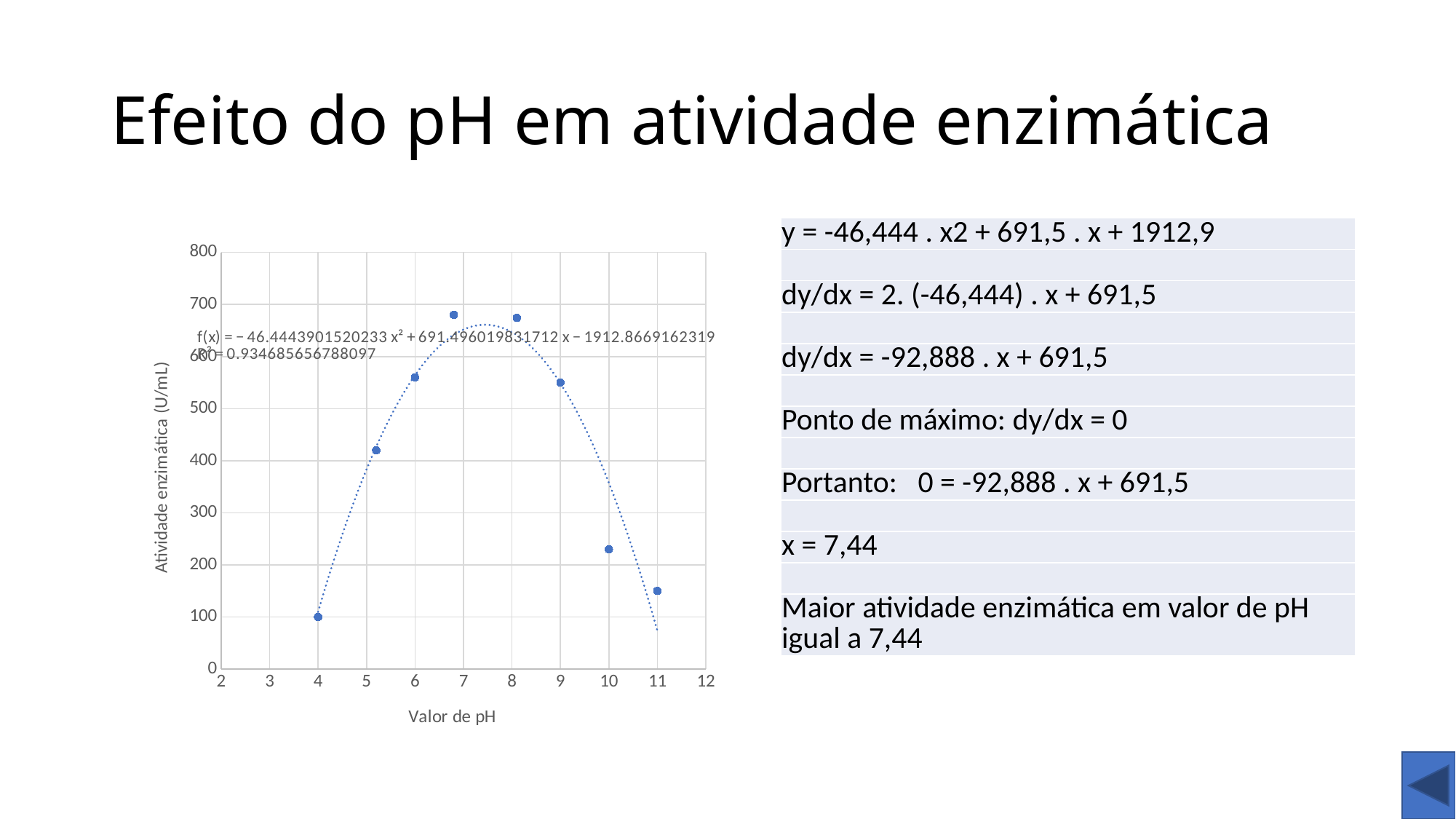
How many data points are plotted in the chart? 8 Which has higher enzymatic activity, the point at pH 6 or the point at pH 10? pH 6 Is the enzymatic activity at pH 9 greater or less than 500 U/mL? greater Is the enzymatic activity at pH 11 greater or less than 200 U/mL? less Is the enzymatic activity at pH 4 greater or less than 200 U/mL? less Which has higher enzymatic activity, the point near pH 5 or the point at pH 9? pH 9 What kind of chart is shown on the slide? scatter chart What is the title of the x axis of the chart? Valor de pH How does enzymatic activity change as pH increases from 4 to 11? rises then falls At which pH value is the enzymatic activity lowest? pH 4